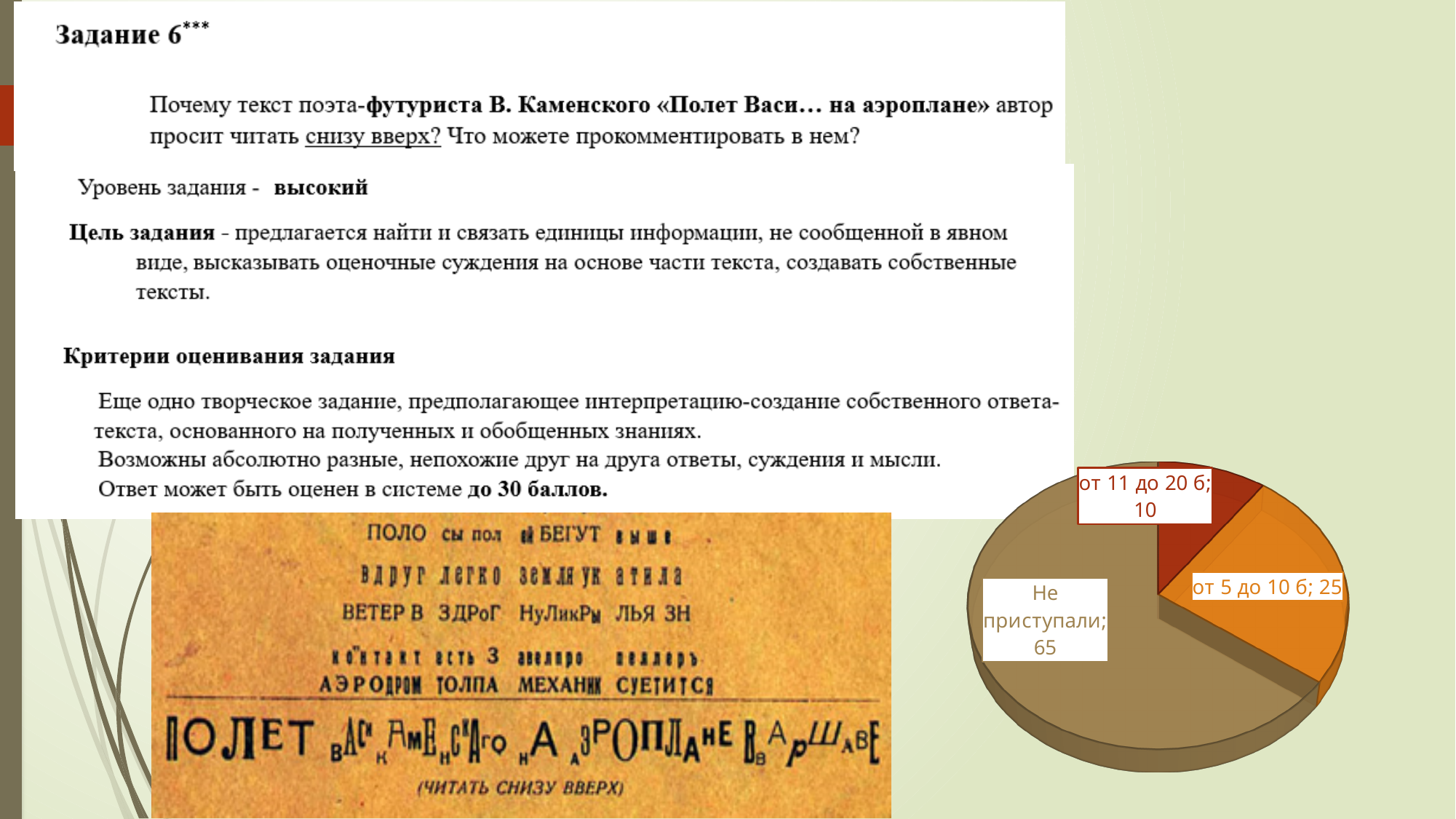
Which slice of the pie chart is the largest? Не приступали Which slice of the pie chart is the smallest? от 11 до 20 б What is the total of all the values shown in the pie chart? 100 What is the value for "от 5 до 10 б" in the pie chart? 25 What share of the pie does the "Не приступали" slice represent? 65% What kind of chart is shown on the slide? pie chart What is the value for "Не приступали" in the pie chart? 65 What is the difference between the values for "от 5 до 10 б" and "от 11 до 20 б"? 15 What is the value for "от 11 до 20 б" in the pie chart? 10 What is the difference between the values for "Не приступали" and "от 5 до 10 б"? 40 How many slices does the pie chart have? 3 Which is larger in the pie chart: "от 5 до 10 б" or "от 11 до 20 б"? от 5 до 10 б